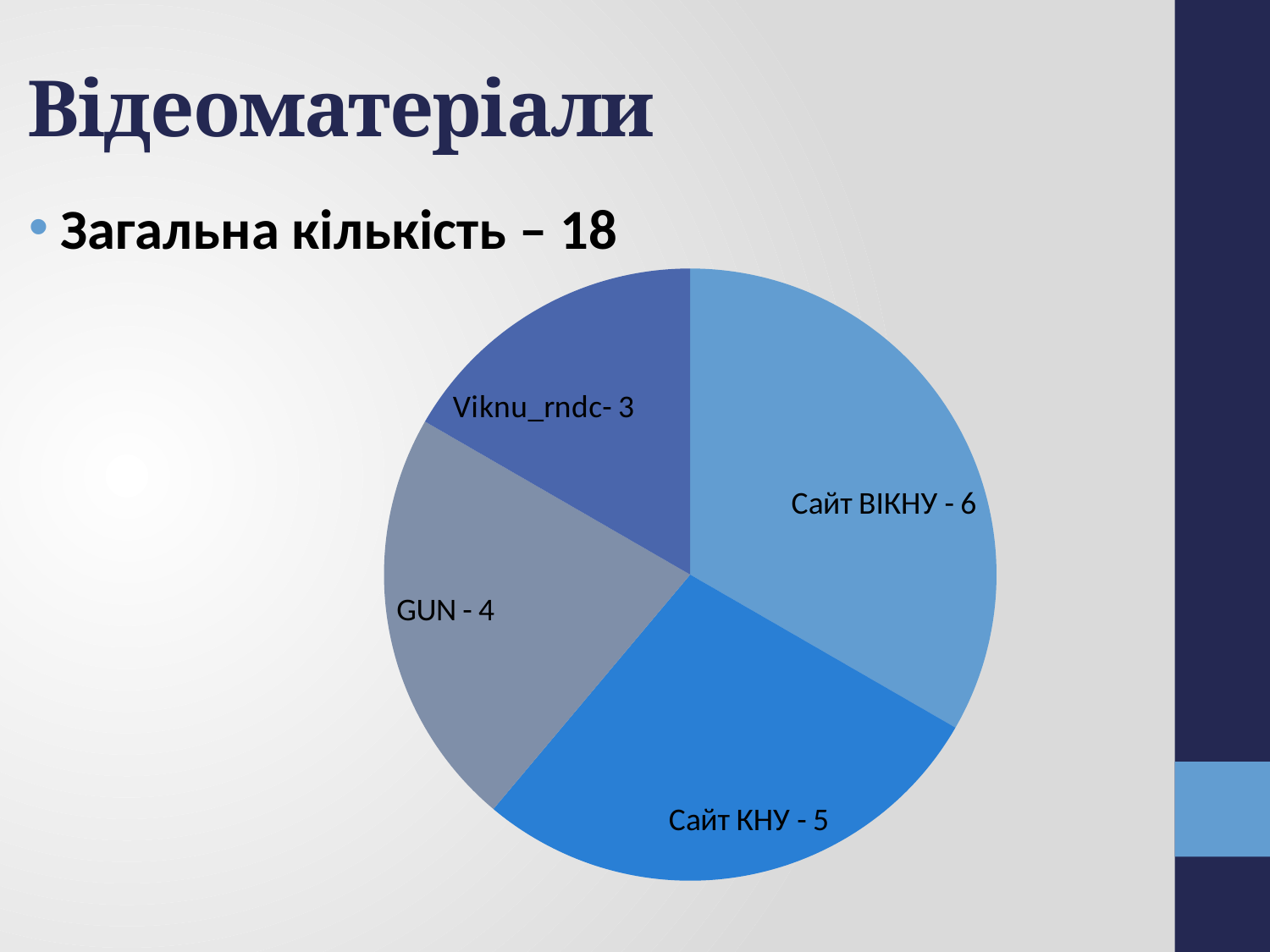
Which category has the largest slice of the pie? Сайт ВІКНУ Which is larger, the value for Сайт КНУ or the value for GUN? Сайт КНУ What is the value for Viknu_rndc? 3 What is the total of all slices in the pie chart? 18 What is the value for Сайт ВІКНУ? 6 What is the value for GUN? 4 What is the difference between the values for Сайт ВІКНУ and Viknu_rndc? 3 Which category has the smallest slice of the pie? Viknu_rndc What kind of chart is shown on the slide? pie chart What is the value for Сайт КНУ? 5 What is the title of the slide containing the pie chart? Відеоматеріали How many slices does the pie chart have? 4